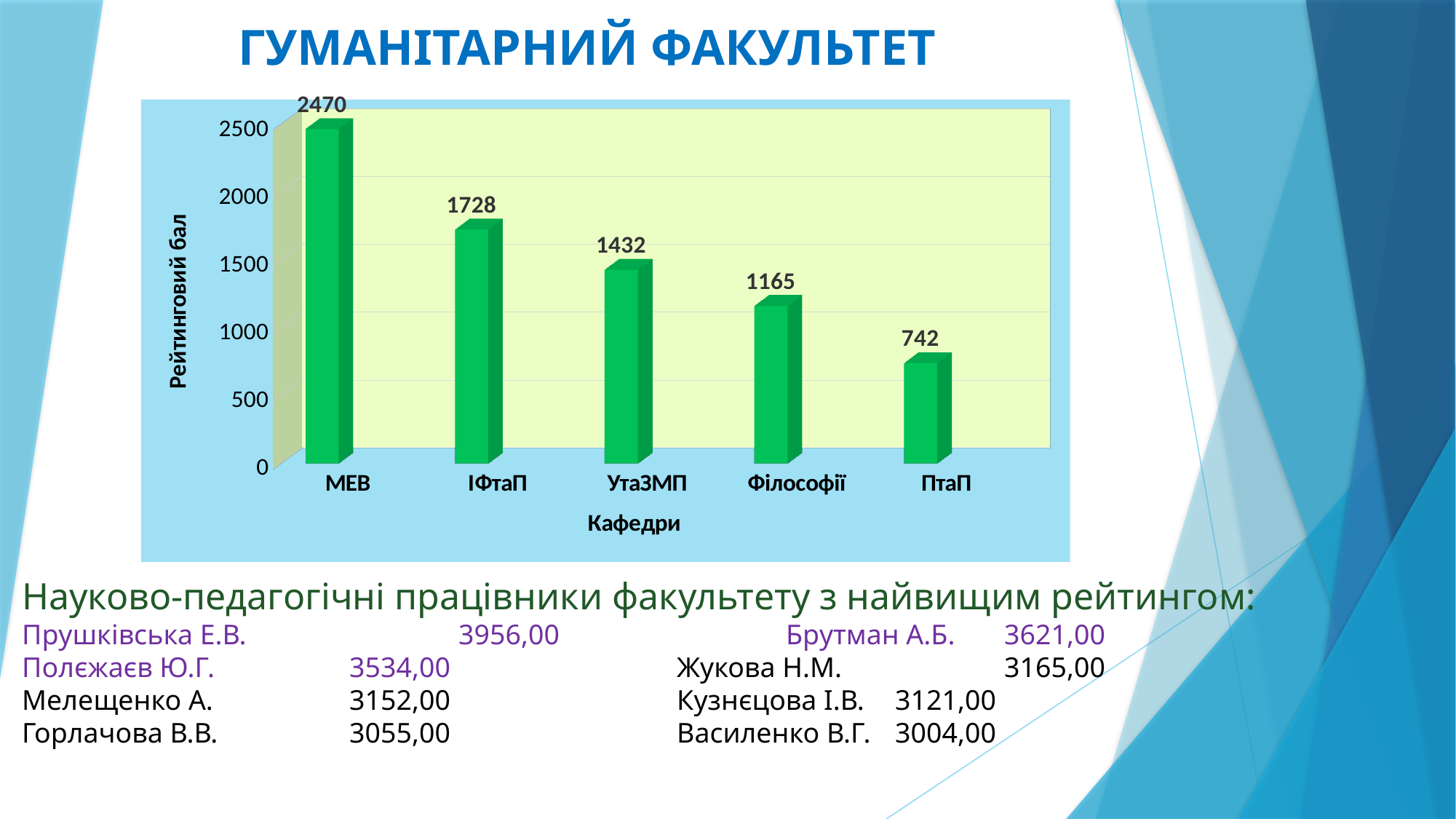
Which department has the lowest rating score? ПтаП What is the difference between the rating scores of МЕВ and ІФтаП? 742 How many departments are shown in the chart? 5 What is the rating score for the Філософії department? 1165 What type of chart is shown on the slide? bar chart What is the rating score for the ПтаП department? 742 Is the rating score for Філософії greater or less than 1000? greater What is the rating score (Рейтинговий бал) for the МЕВ department? 2470 Which department has the highest rating score? МЕВ Do the rating scores rise or fall from left to right across the departments? fall Which department has a higher rating score, ІФтаП or УтаЗМП? ІФтаП What is the difference between the rating scores of УтаЗМП and Філософії? 267